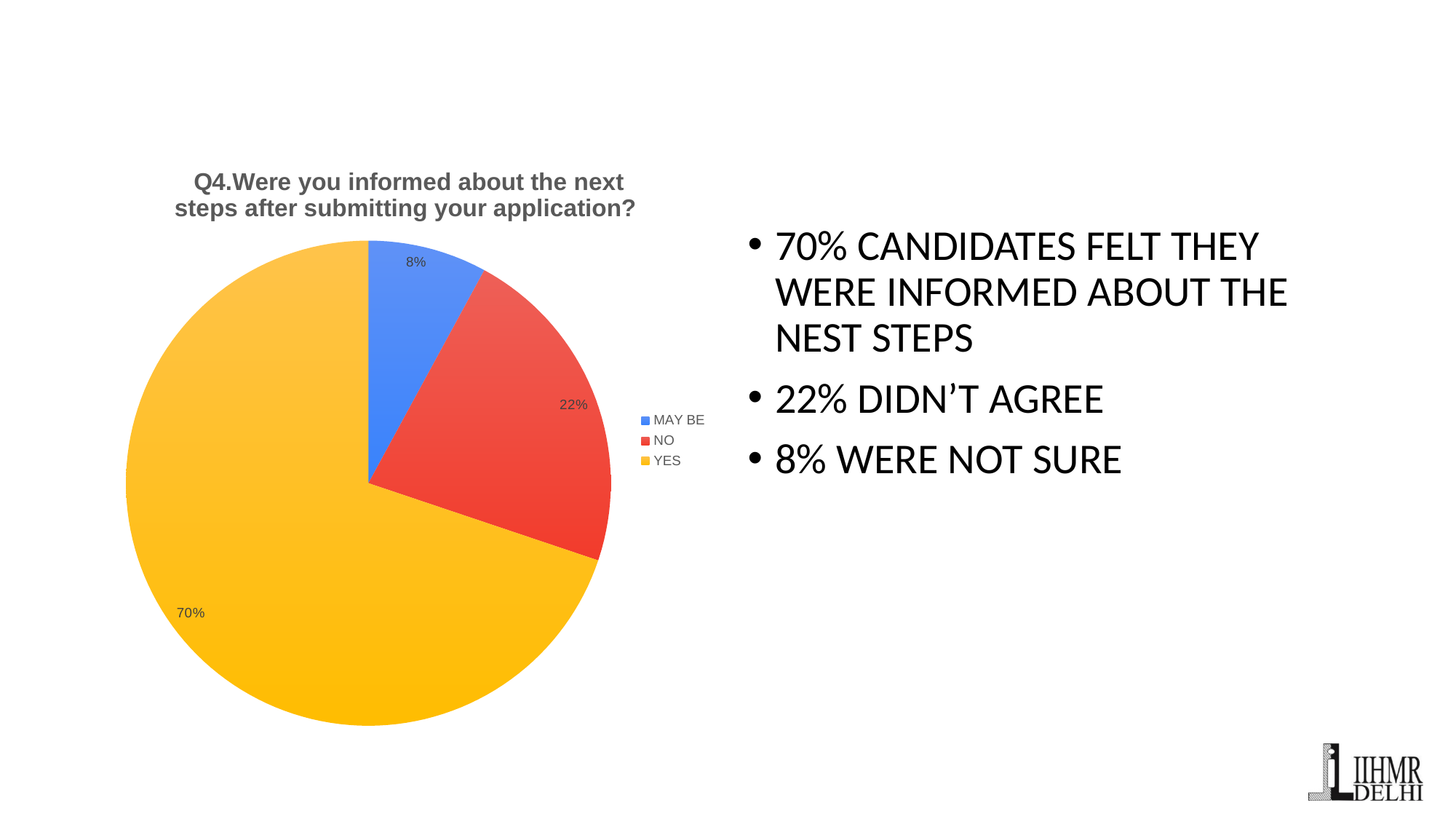
What share of the pie does NO represent? 22% How many categories does the pie chart show? 3 Which category has the smallest slice of the pie? MAY BE What share of the pie does MAY BE represent? 8% What is the difference in percentage points between the NO and MAY BE slices? 14 What share of the pie does YES represent? 70% Which category has the largest slice of the pie? YES What is the title of the pie chart? Q4.Were you informed about the next steps after submitting your application? What is the difference in percentage points between the YES and NO slices? 48 What kind of chart is shown on the slide? pie chart What colour is the YES slice in the pie chart? yellow Which slice is larger, NO or MAY BE? NO